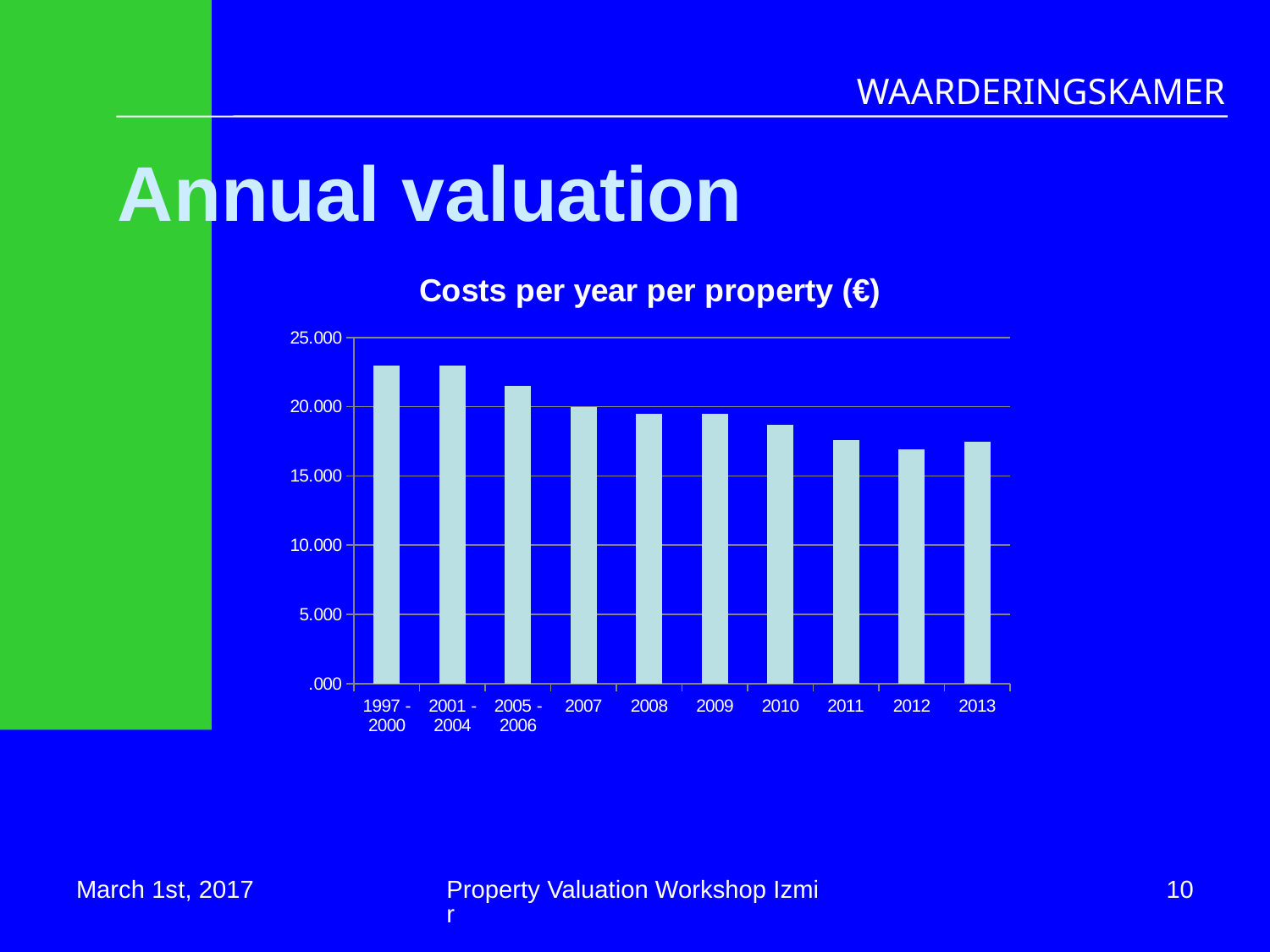
Which category has the lowest cost per year per property? 2012 Which is larger, the value for 1997 - 2000 or the value for 2013? 1997 - 2000 What is the title of the chart? Costs per year per property (€) Is the value for 2010 greater or less than 20.000? less How many categories are shown on the x axis of the chart? 10 Is the value for 2011 greater or less than 20.000? less Which is larger, the value for 2005 - 2006 or the value for 2010? 2005 - 2006 Is the value for 1997 - 2000 greater or less than 20.000? greater What kind of chart is shown on the slide? Bar chart Do the costs per year per property generally rise or fall from 1997 - 2000 to 2013? Fall